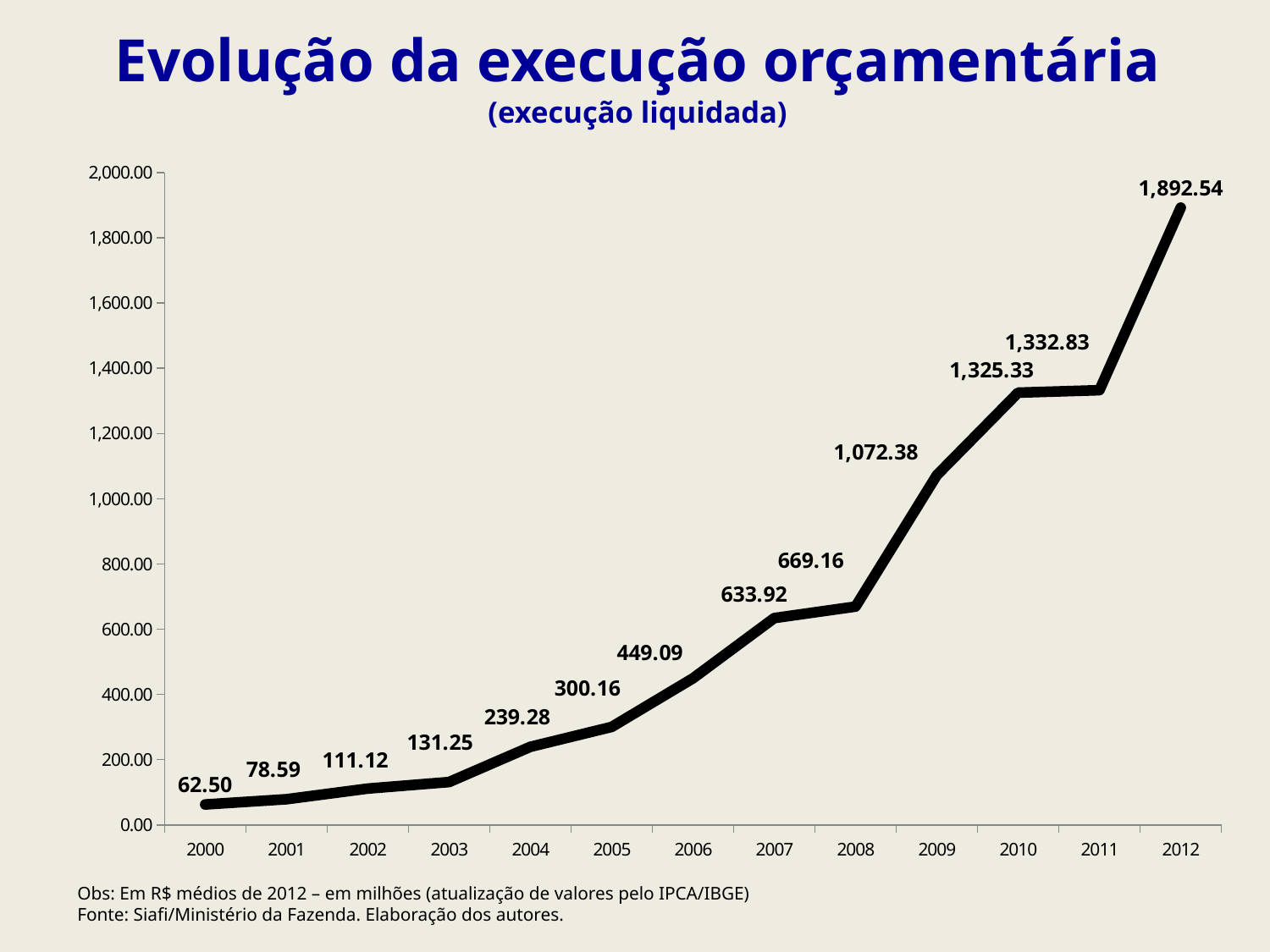
How many years are plotted on the chart? 13 What is the value for 2012? 1,892.54 What is the difference between the values for 2008 and 2007? 35.24 What is the difference between the values for 2012 and 2011? 559.71 What is the value for 2009? 1,072.38 Do the values rise or fall from 2000 to 2012? Rise Which year has the highest value? 2012 What kind of chart is shown on the slide? Line chart What is the value for 2000? 62.50 Which year has the lowest value? 2000 Which is larger, the value for 2004 or the value for 2005? 2005 What is the value for 2006? 449.09